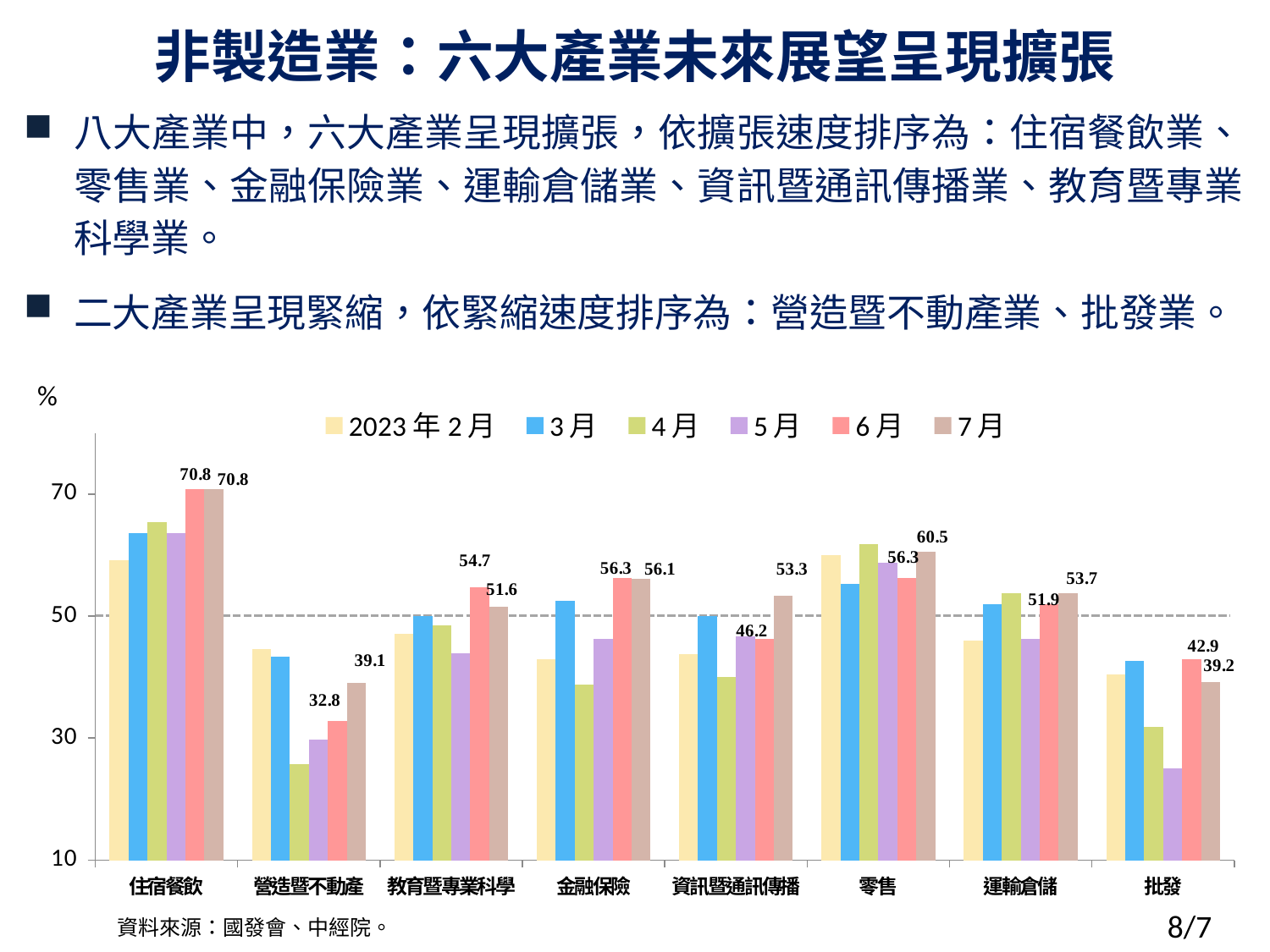
Which industry has the highest 7月 value? 住宿餐飲 What is the difference between the 7月 and 6月 values for 營造暨不動產? 6.3 How many industries are shown on the x axis? 8 Which is larger for 批發: the 6月 value or the 7月 value? 6月 What is the 7月 value for 零售? 60.5 What is the 6月 value for 營造暨不動產? 32.8 What is the difference between the 7月 and 6月 values for 資訊暨通訊傳播? 7.1 Is the 4月 value for 營造暨不動產 greater or less than 30? less What kind of chart is shown on the slide? bar chart How many series does the legend list? 6 What is the 7月 value for 資訊暨通訊傳播? 53.3 Which industry has the lowest 7月 value? 營造暨不動產